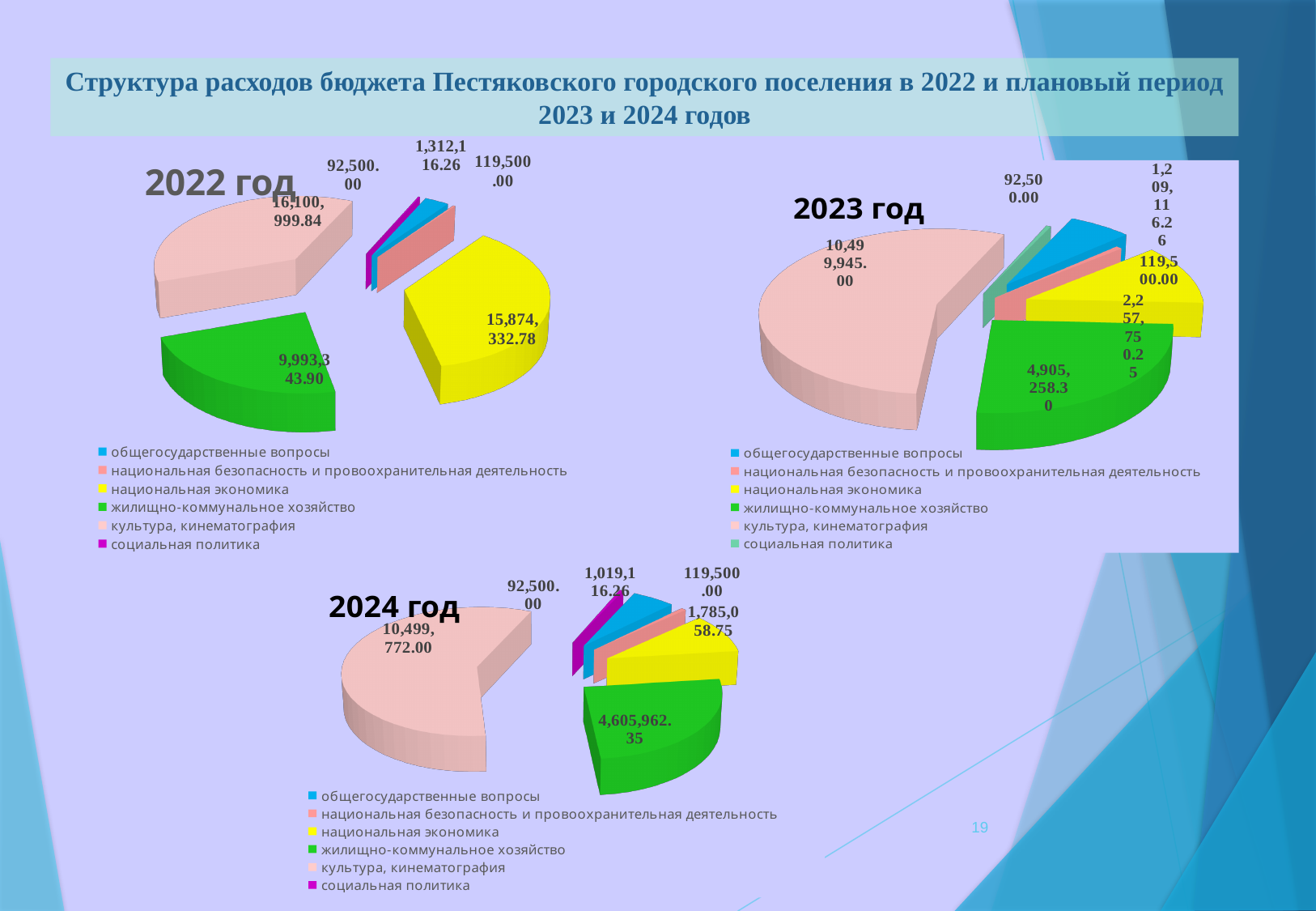
In the 2023 год chart, what is the value for культура, кинематография? 10,499,945.00 In the 2022 год chart, which category has the smallest value? социальная политика How many categories does the legend of the 2024 год chart list? 6 In the 2023 год chart, what is the difference between жилищно-коммунальное хозяйство and национальная экономика? 2,647,508.05 In the 2023 год chart, which is larger: жилищно-коммунальное хозяйство or национальная экономика? жилищно-коммунальное хозяйство What kind of chart is used for the 2022 год data? Pie chart In the 2022 год chart, which category has the largest value? культура, кинематография In the 2022 год chart, what is the value for национальная экономика? 15,874,332.78 In the 2022 год chart, what is the value for жилищно-коммунальное хозяйство? 9,993,343.90 In the 2024 год chart, what colour represents национальная экономика? Yellow In the 2024 год chart, what is the value for жилищно-коммунальное хозяйство? 4,605,962.35 In the 2022 год chart, what is the difference between культура, кинематография and жилищно-коммунальное хозяйство? 6,107,655.94